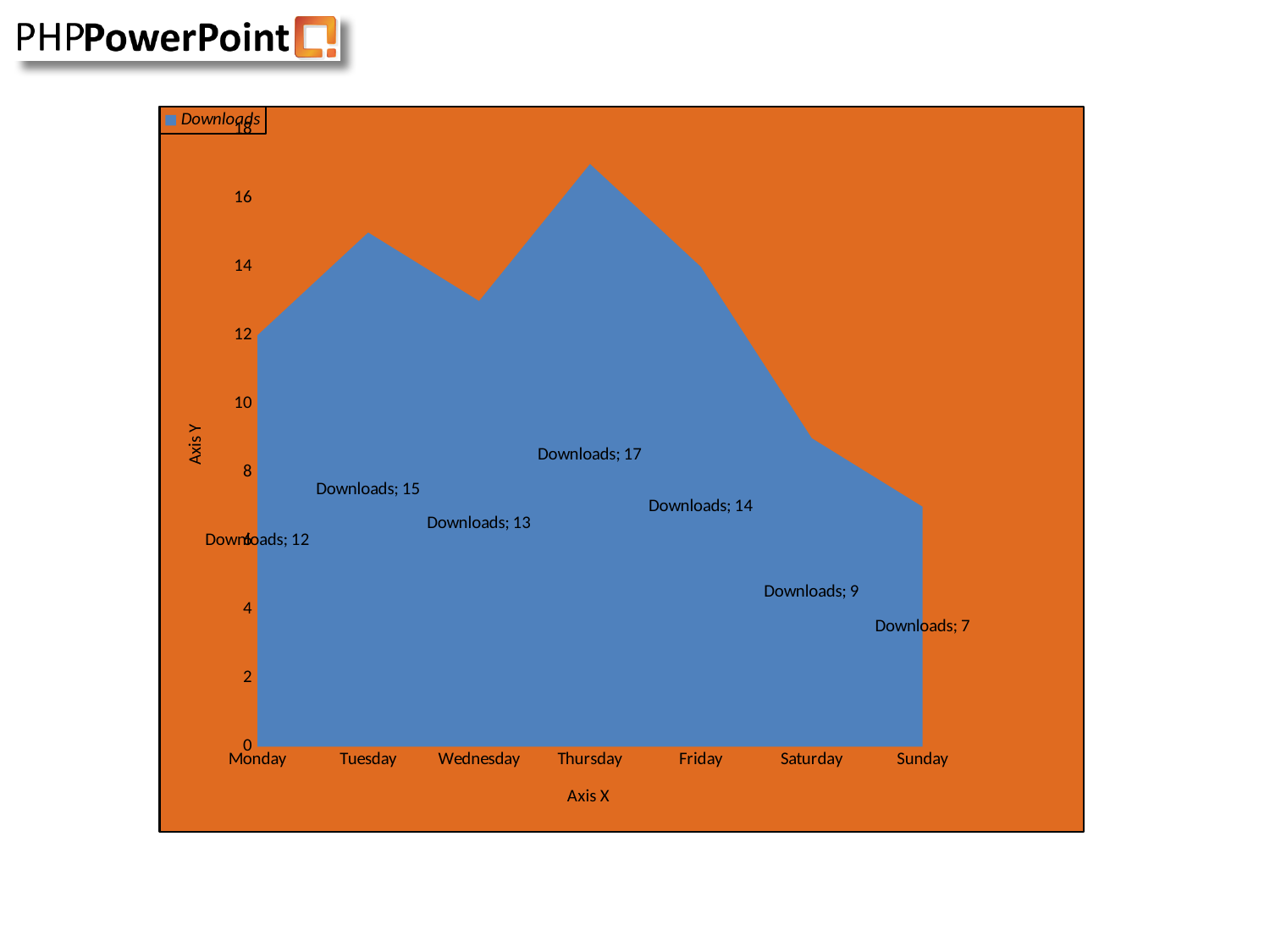
What is the title of the vertical axis? Axis Y Is the Downloads value for Saturday greater or less than 10? less Which has a larger Downloads value, Tuesday or Friday? Tuesday How many series does the legend list? 1 What is the Downloads value for Sunday? 7 What is the Downloads value for Thursday? 17 Which day has the lowest Downloads value? Sunday Which day has the highest Downloads value? Thursday How many days are shown on the x axis? 7 What is the difference between the Downloads values for Thursday and Sunday? 10 What is the Downloads value for Tuesday? 15 What kind of chart is shown on the slide? area chart